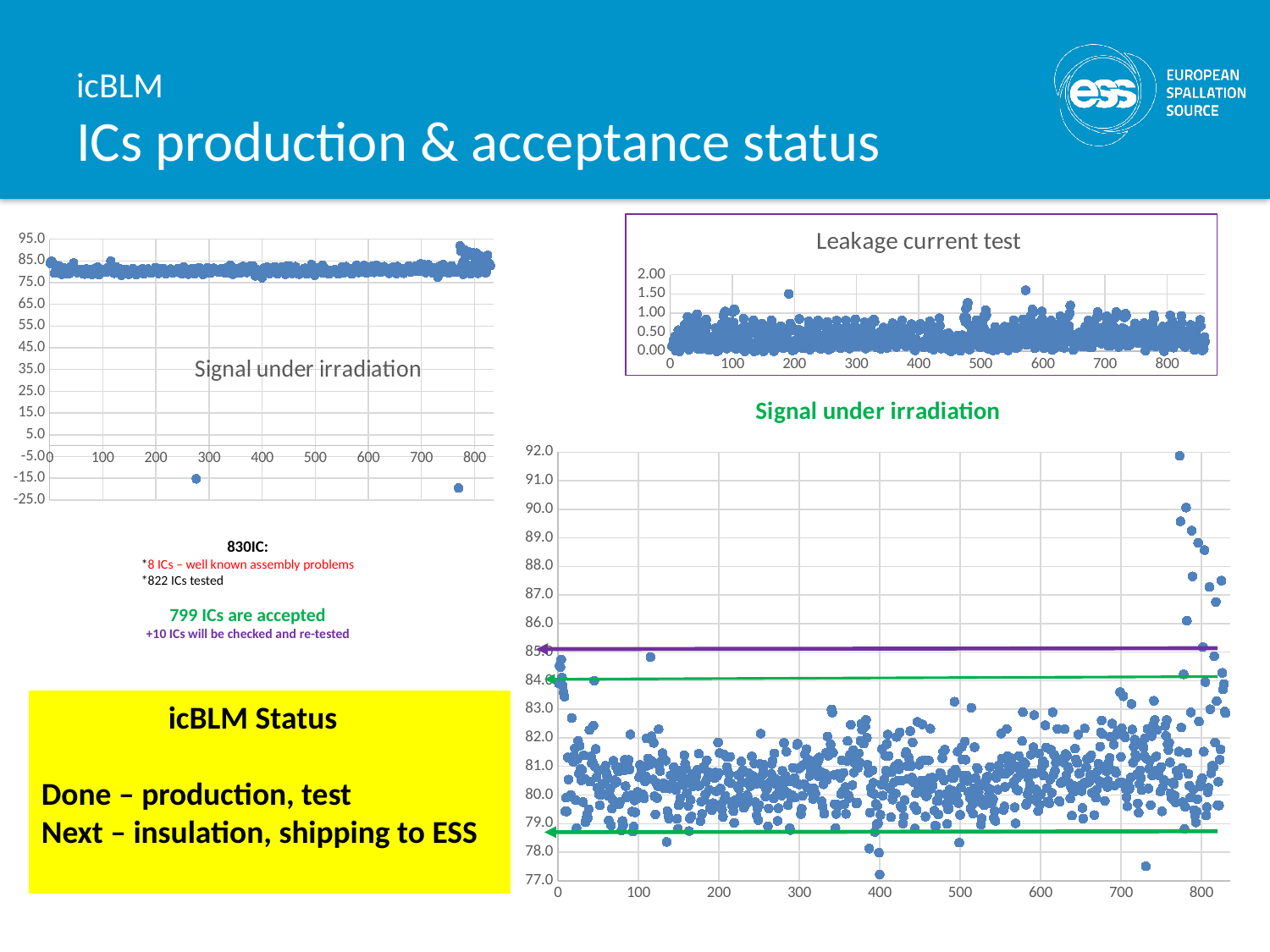
What is the title of the chart in the top right of the slide? Leakage current test In the "Leakage current test" chart, is the highest plotted point greater or less than 2.00? less What kind of chart is the "Leakage current test" chart in the top right of the slide? scatter chart In the "Leakage current test" chart, is the highest plotted point greater or less than 1.50? greater In the large "Signal under irradiation" chart in the bottom right, is the point plotted near x = 400 at the very bottom greater or less than 79.0? less What kind of chart is the large "Signal under irradiation" chart in the bottom right of the slide? scatter chart In the "Signal under irradiation" chart in the top left, how many plotted points lie below 0 on the y-axis? 2 What is the highest y-axis tick label on the "Signal under irradiation" chart in the top left of the slide? 95.0